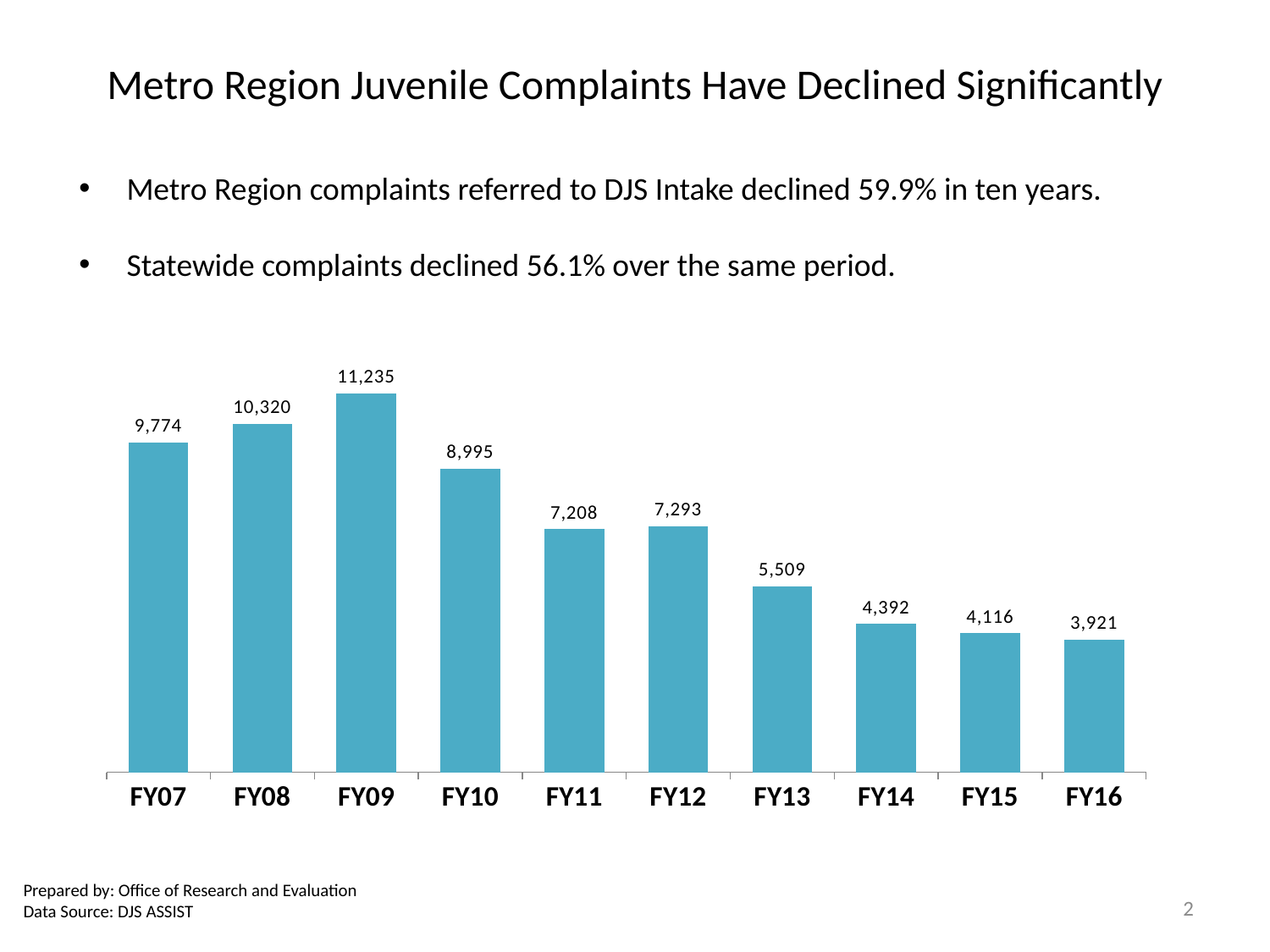
What is the value for FY09? 11,235 Which is larger, the value for FY11 or FY12? FY12 What is the value for FY16? 3,921 What kind of chart is shown on the slide? Bar chart What is the difference between the values for FY09 and FY10? 2,240 Which is larger, the value for FY14 or FY15? FY14 Do the values generally rise or fall from FY09 to FY16? Fall What is the value for FY12? 7,293 Which fiscal year has the lowest value? FY16 Which fiscal year has the highest value? FY09 What is the difference between the values for FY07 and FY16? 5,853 How many fiscal years are shown on the chart? 10